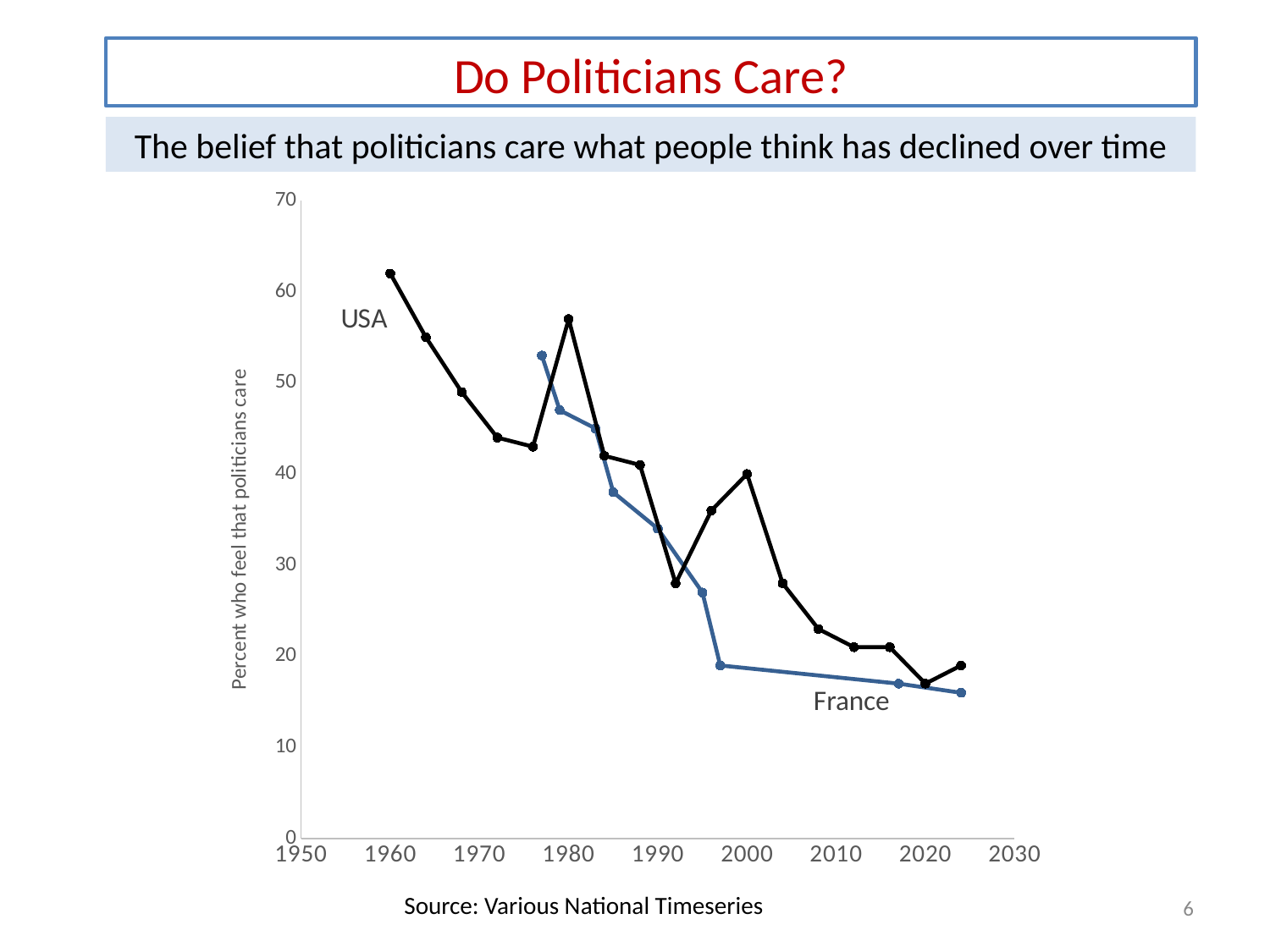
Is the USA value around 1992 greater or less than 30? less Overall, do the values for the USA rise or fall from 1960 to 2024? fall What kind of chart is shown on the slide? line chart Around 2000, which series has the higher value, USA or France? USA How many series are plotted on the chart? 2 Is the first France value (late 1970s) greater or less than 50? greater Overall, do the values for France rise or fall along the x axis? fall Is the last France value (around 2024) greater or less than 20? less Which two countries are plotted on the chart? USA and France What is the label on the vertical axis of the chart? Percent who feel that politicians care Which series reaches the highest value anywhere on the chart? USA